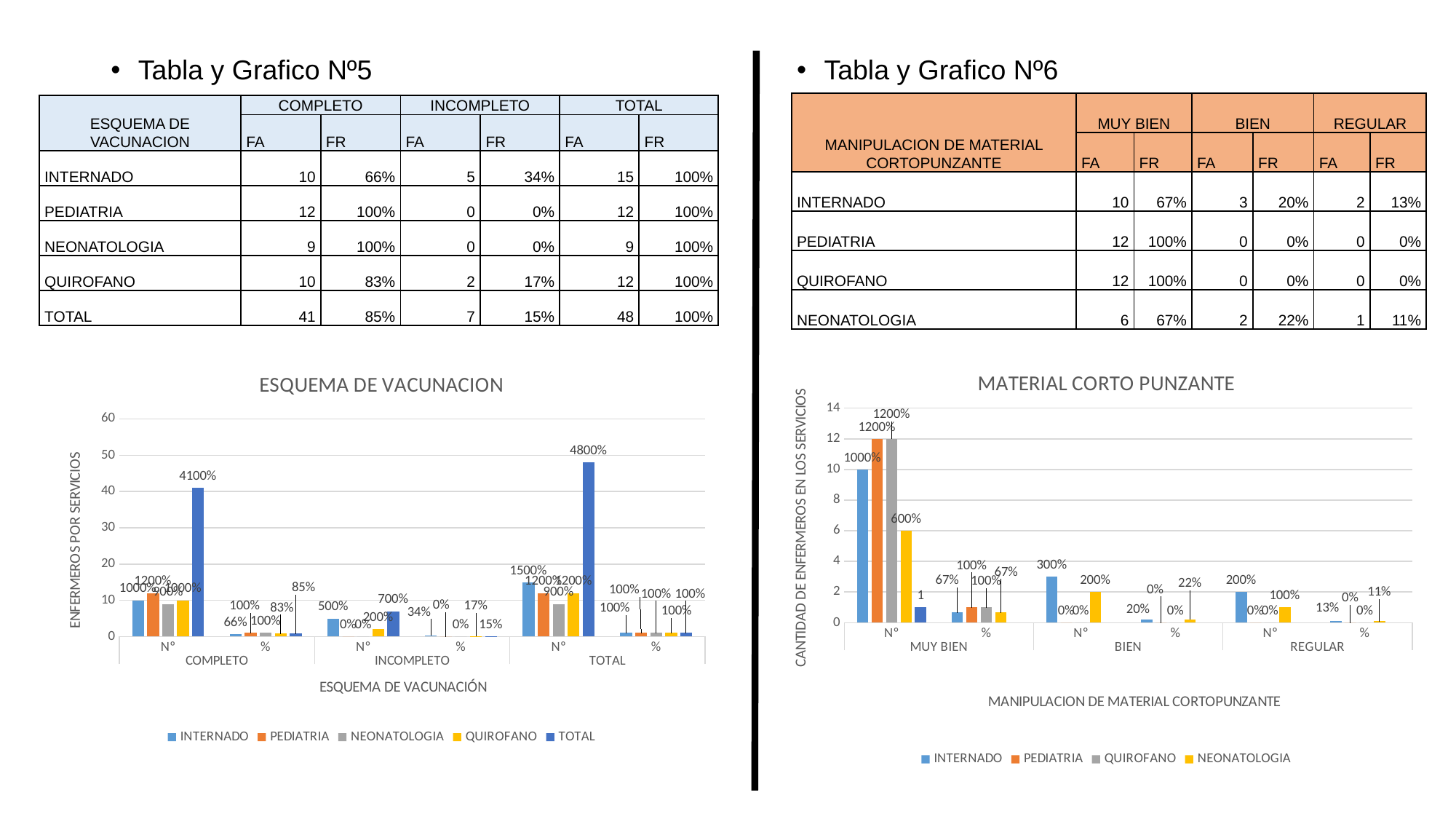
In the "ESQUEMA DE VACUNACION" chart, what data label is shown on the TOTAL bar in the N° group under COMPLETO? 4100% In the "ESQUEMA DE VACUNACION" chart, is the TOTAL bar in the N° group under COMPLETO greater or less than 30 on the y axis? greater In the "MATERIAL CORTO PUNZANTE" chart, what data label is shown on the INTERNADO bar in the N° group under BIEN? 300% How many series does the legend of the "ESQUEMA DE VACUNACION" chart list? 5 In the "ESQUEMA DE VACUNACION" chart, which series has the tallest bar in the N° group under TOTAL? TOTAL In the "MATERIAL CORTO PUNZANTE" chart, what data label is shown on the NEONATOLOGIA bar in the N° group under MUY BIEN? 600% What kind of chart is the "ESQUEMA DE VACUNACION" chart on the left? bar chart What kind of chart is the "MATERIAL CORTO PUNZANTE" chart on the right? bar chart What is the y-axis title of the "ESQUEMA DE VACUNACION" chart? ENFERMEROS POR SERVICIOS In the "ESQUEMA DE VACUNACION" chart, what data label is shown on the TOTAL bar in the N° group under TOTAL? 4800% In the "MATERIAL CORTO PUNZANTE" chart, is the INTERNADO bar in the N° group under MUY BIEN taller or shorter than the NEONATOLOGIA bar in the same group? taller How many series does the legend of the "MATERIAL CORTO PUNZANTE" chart list? 4